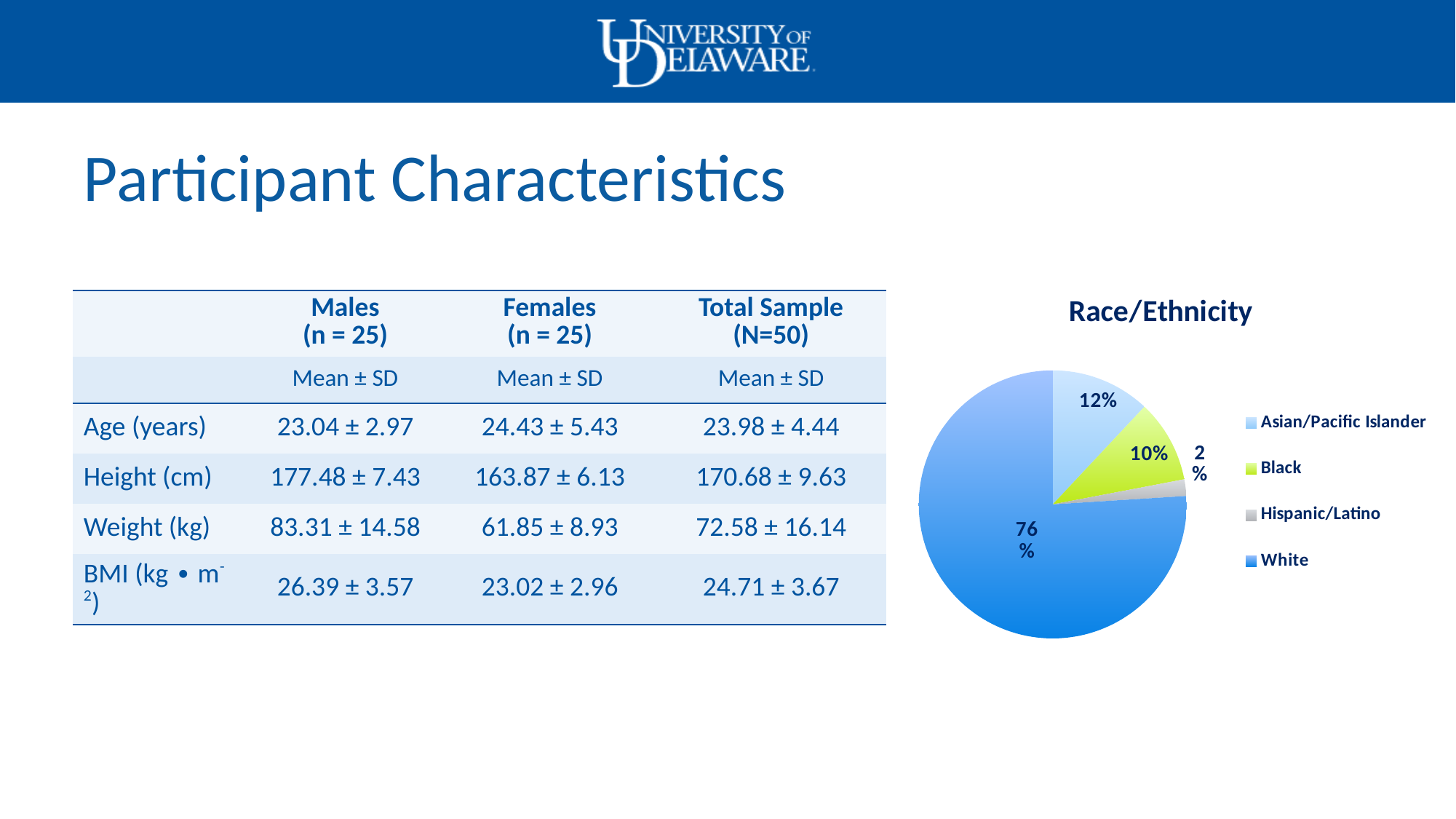
What type of chart is shown on the slide? pie chart What is the difference between the White share and the Asian/Pacific Islander share? 64% Which category has the largest slice of the pie? White What colour is the Black slice in the pie chart? green What share of the pie is White? 76% What share of the pie is Asian/Pacific Islander? 12% What share of the pie is Hispanic/Latino? 2% Which category has the smallest slice of the pie? Hispanic/Latino What share of the pie is Black? 10% Which is larger, the Asian/Pacific Islander slice or the Black slice? Asian/Pacific Islander How many categories does the pie chart show? 4 What is the title of the chart? Race/Ethnicity